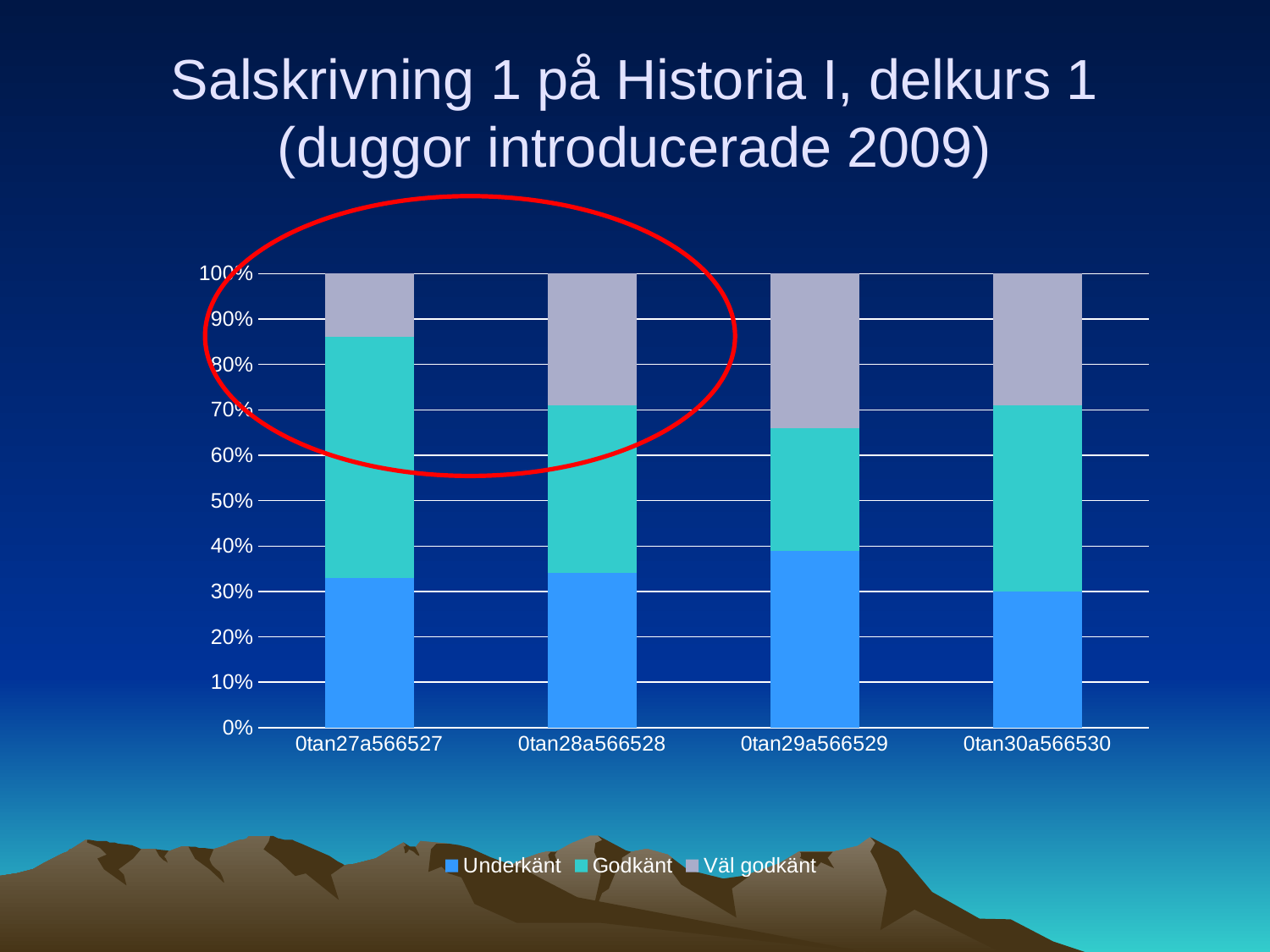
What kind of chart is shown on the slide? Stacked bar chart Which category has the largest Underkänt segment? 0tan29a566529 Is the Underkänt share for 0tan30a566530 greater or less than 40%? less What are the three legend entries, in order? Underkänt, Godkänt, Väl godkänt How many categories are shown on the x axis? 4 Is the Underkänt share for 0tan29a566529 greater or less than 30%? greater What is the total height of each stacked bar? 100% How many series does the legend list? 3 Which category has the smallest Väl godkänt segment? 0tan27a566527 Is the Väl godkänt share for 0tan27a566527 greater or less than 20%? less Is the Godkänt segment larger for 0tan27a566527 or for 0tan29a566529? 0tan27a566527 Which category has the largest Väl godkänt segment? 0tan29a566529